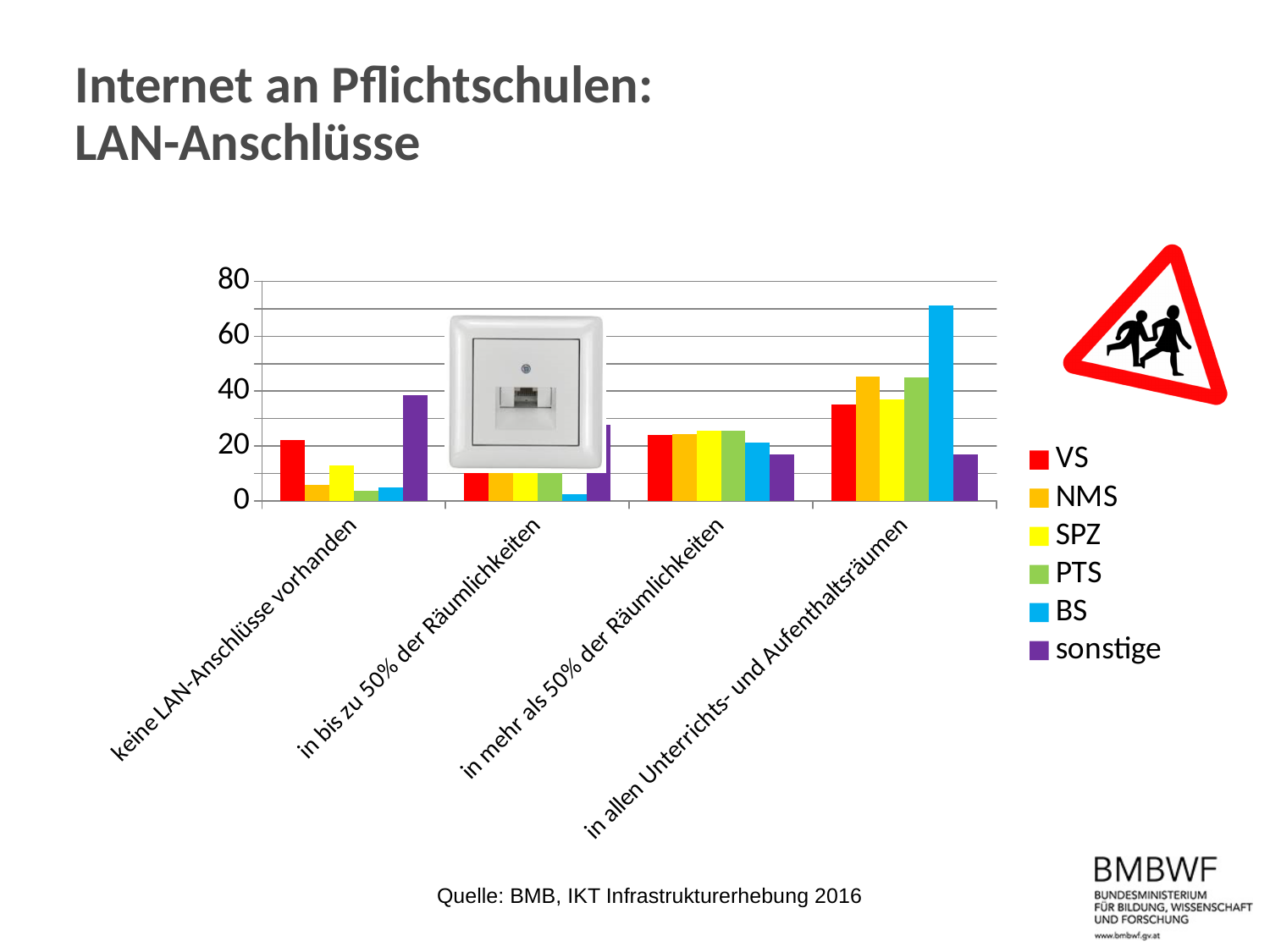
Which series has the highest value in the category "in allen Unterrichts- und Aufenthaltsräumen"? BS In the category "in allen Unterrichts- und Aufenthaltsräumen", which is larger: the value for BS or the value for VS? BS Which colour represents the series BS in the legend? blue Is the value for BS in the category "in allen Unterrichts- und Aufenthaltsräumen" greater or less than 60? greater How many categories are shown on the x axis? 4 In the category "keine LAN-Anschlüsse vorhanden", which is larger: the value for VS or the value for NMS? VS Is the value for sonstige in the category "in allen Unterrichts- und Aufenthaltsräumen" greater or less than 40? less Is the value for sonstige in the category "keine LAN-Anschlüsse vorhanden" greater or less than 20? greater What kind of chart is shown on the slide? bar chart How many series does the legend list? 6 Which series has the highest value in the category "keine LAN-Anschlüsse vorhanden"? sonstige